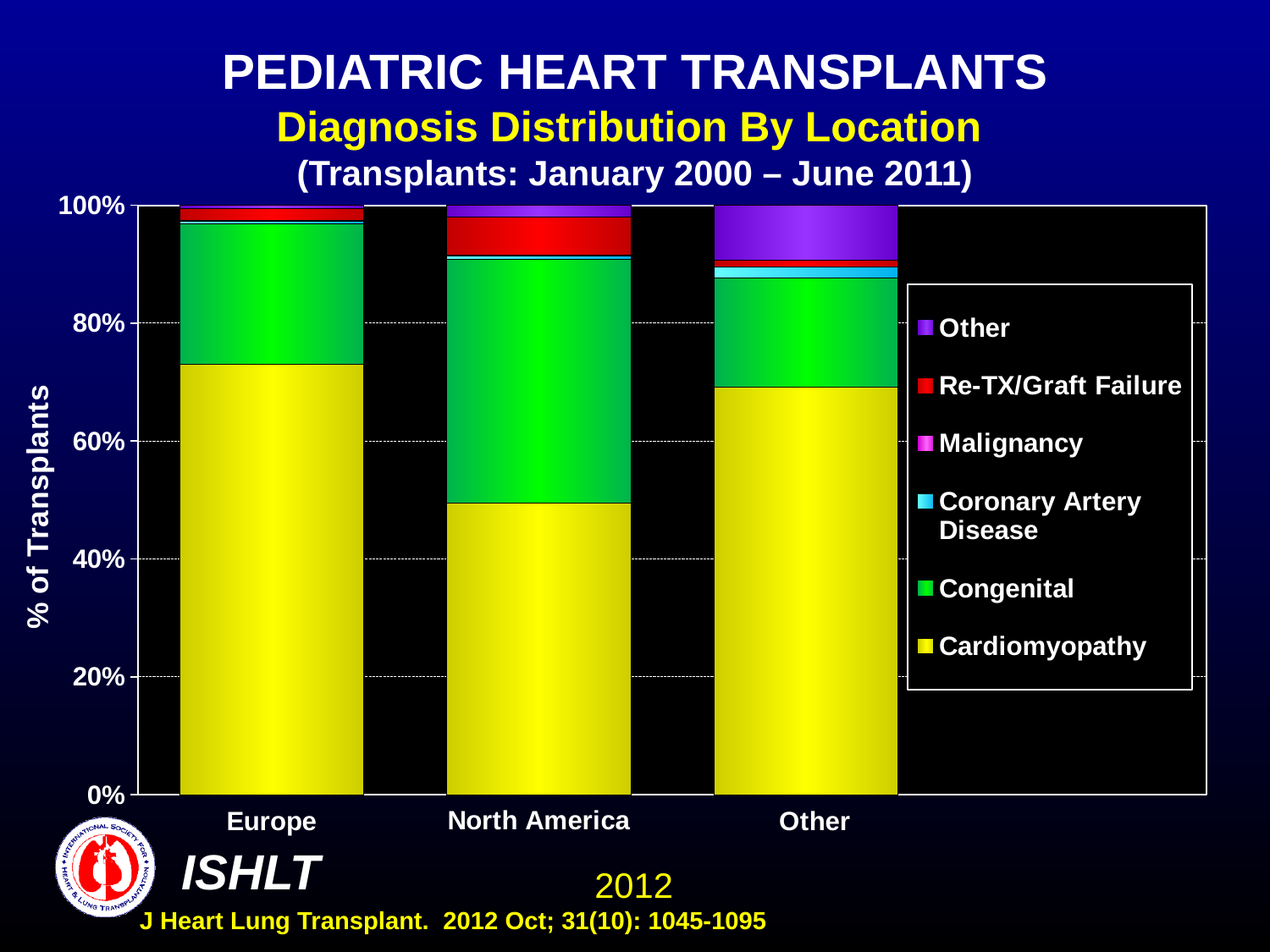
What kind of chart is shown on the slide? stacked bar chart How many series does the legend list? 6 Which location has the largest Congenital segment? North America What is the label on the y axis of the chart? % of Transplants Which diagnosis is shown in yellow in the legend? Cardiomyopathy Which location has the largest 'Other' diagnosis segment? Other Is the Cardiomyopathy share for the Other location greater or less than 60%? greater Which is larger, the Congenital share in North America or the Congenital share in Europe? North America Is the Cardiomyopathy share for Europe greater or less than 60%? greater How many locations are shown on the x axis of the chart? 3 Which location has the lowest share of Cardiomyopathy? North America Is the Cardiomyopathy share for North America greater or less than 60%? less